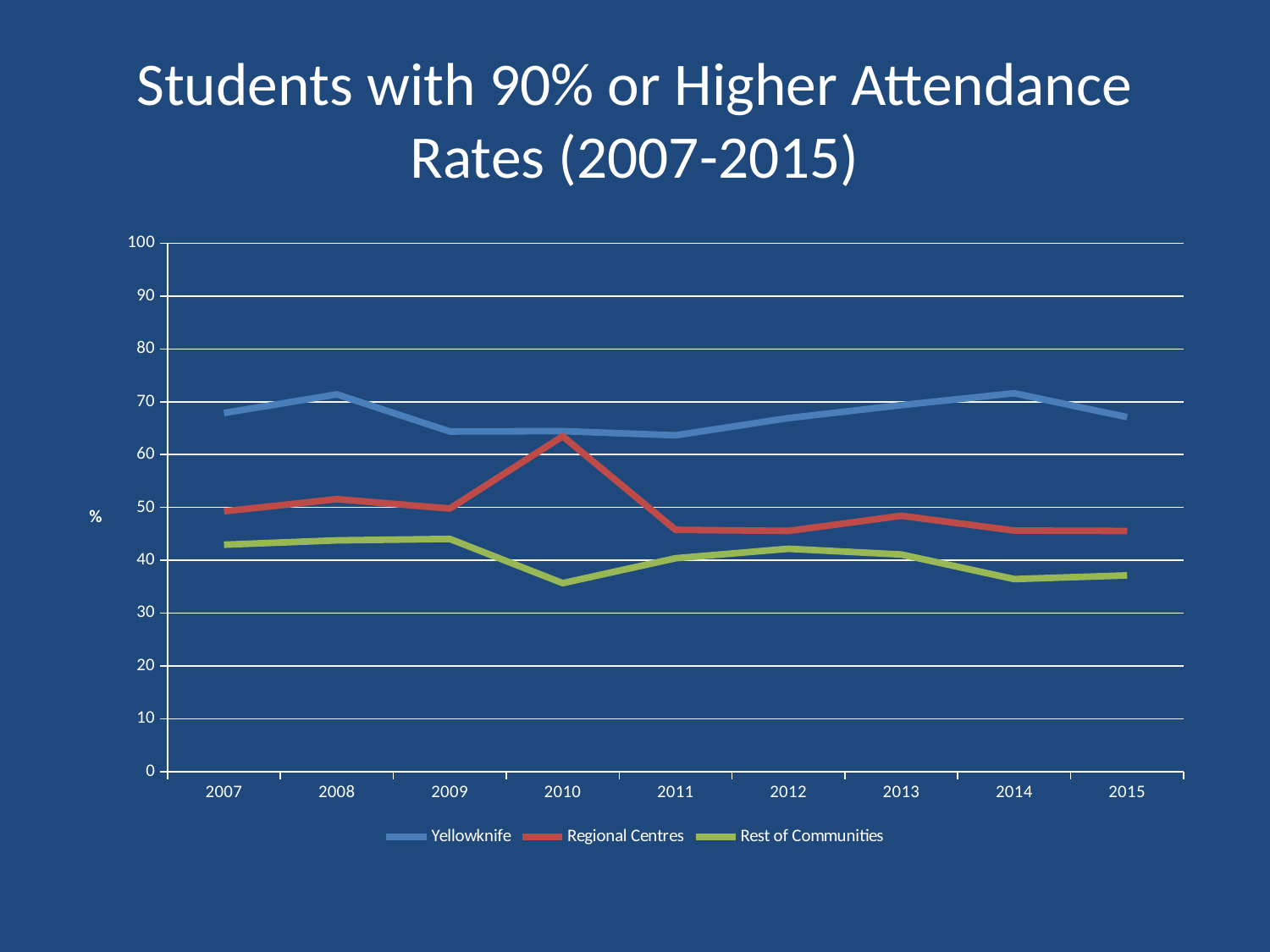
Is the value for Yellowknife in 2011 greater or less than 70? less Is the value for Rest of Communities in 2010 greater or less than 40? less What is the label on the y axis? % How many years are shown along the x axis? 9 For Rest of Communities, which year has the higher value: 2009 or 2010? 2009 In 2007, which series has the higher value: Yellowknife or Regional Centres? Yellowknife In which year does the Regional Centres series reach its highest value? 2010 Is the value for Regional Centres in 2010 greater or less than 60? greater Does the Regional Centres series rise or fall from 2010 to 2011? fall What kind of chart is shown on the slide? line chart How many series does the legend list? 3